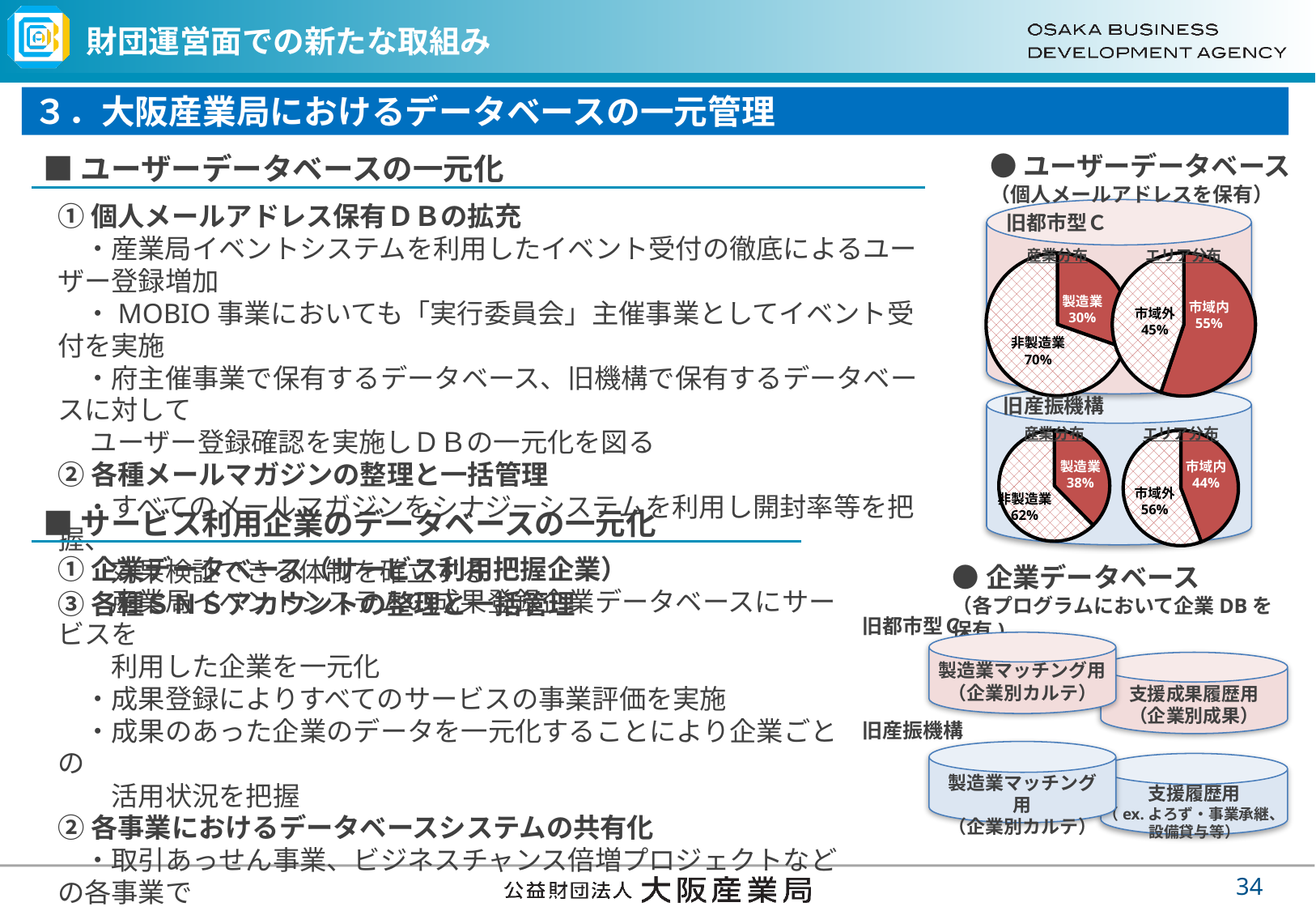
In the 旧都市型C エリア分布 pie chart, what share is 市域内? 55% How many slices does the 旧産振機構 産業分布 pie chart have? 2 What is the difference between the 非製造業 and 製造業 shares in the 旧産振機構 産業分布 pie chart? 24% What type of chart is used to show the 産業分布 and エリア分布 under ユーザーデータベース? Pie chart In the 旧都市型C 産業分布 pie chart, what share is 製造業? 30% What is the difference between the 市域内 and 市域外 shares in the 旧都市型C エリア分布 pie chart? 10% In the 旧都市型C 産業分布 pie chart, which slice is the largest? 非製造業 In the 旧産振機構 産業分布 pie chart, what share is 製造業? 38% In the 旧都市型C エリア分布 pie chart, what share is 市域外? 45% In the 旧産振機構 エリア分布 pie chart, which slice is larger, 市域内 or 市域外? 市域外 In the 旧都市型C 産業分布 pie chart, what share is 非製造業? 70% In the 旧産振機構 エリア分布 pie chart, what share is 市域外? 56%